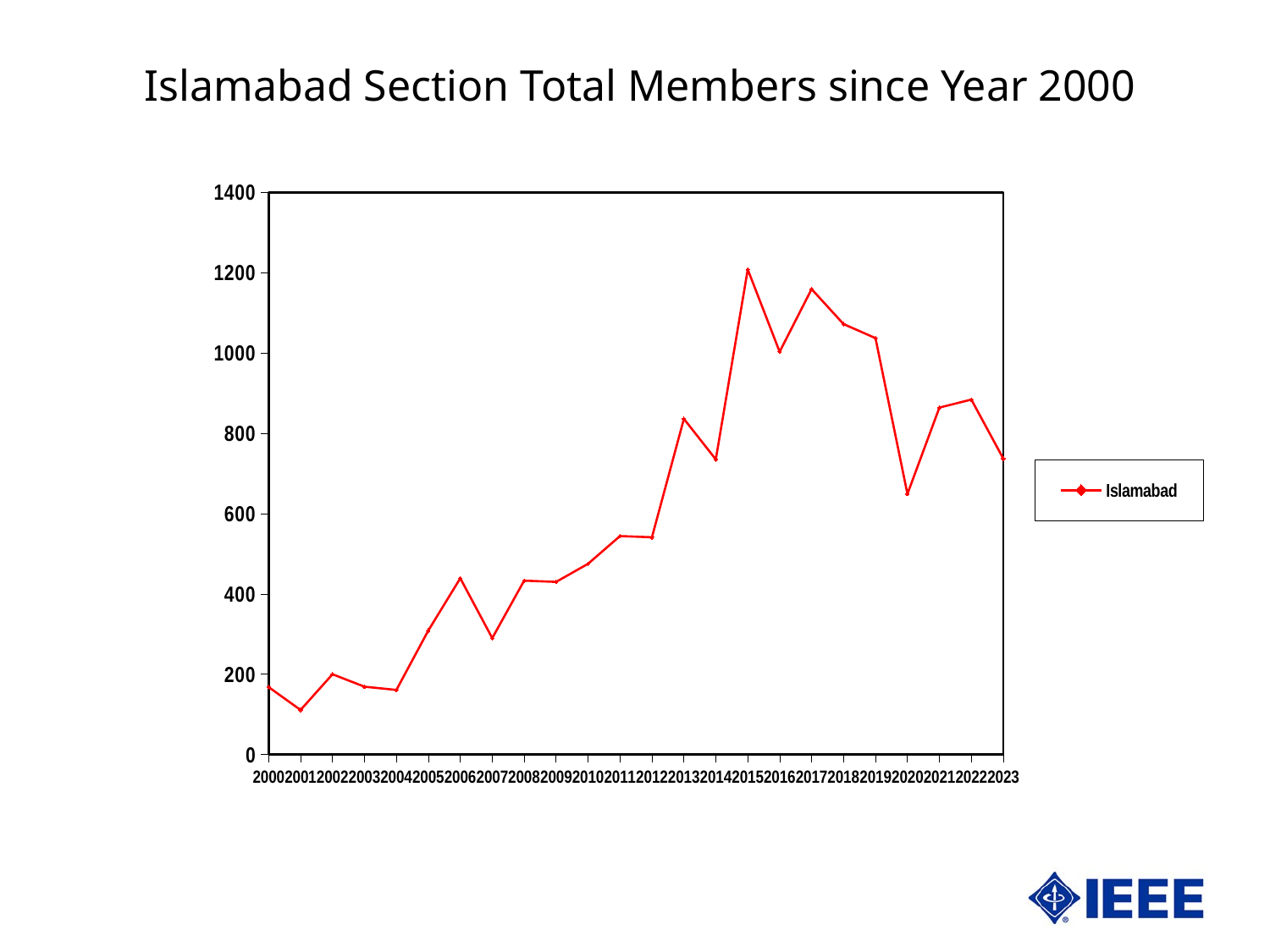
Is the value for 2015 greater or less than 1000? greater In which year is the number of members highest? 2015 What is the title of the chart? Islamabad Section Total Members since Year 2000 How many years are plotted along the x axis? 24 Is the value for 2020 greater or less than 800? less Do the values rise or fall from 2017 to 2020? fall How many series does the legend list? 1 What type of chart is shown on the slide? line chart Is the value for 2001 greater or less than 200? less What is the name of the series shown in the legend? Islamabad Which year has more members, 2015 or 2017? 2015 In which year is the number of members lowest? 2001